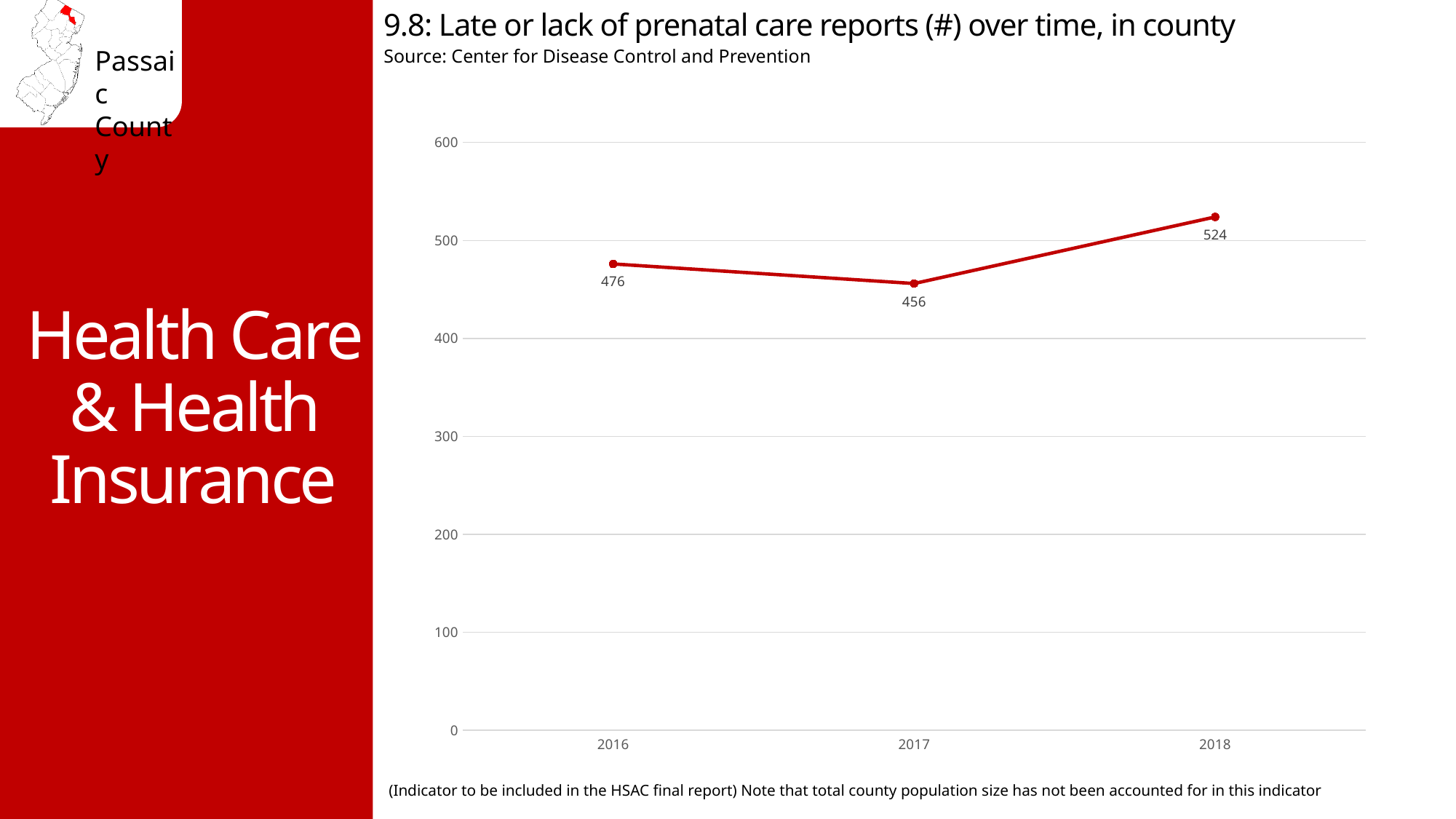
Which year has the highest number of late or lack of prenatal care reports? 2018 Which year has more late or lack of prenatal care reports, 2016 or 2018? 2018 What is the number of late or lack of prenatal care reports in 2016? 476 What is the difference between the number of reports in 2016 and in 2017? 20 Which year has the lowest number of late or lack of prenatal care reports? 2017 What is the difference between the number of reports in 2018 and in 2017? 68 What is the number of late or lack of prenatal care reports in 2018? 524 How many years are plotted on the chart? 3 What kind of chart is shown on the slide? line chart Is the value for 2018 greater or less than 500? greater What is the number of late or lack of prenatal care reports in 2017? 456 What is the source of the data shown in the chart? Center for Disease Control and Prevention